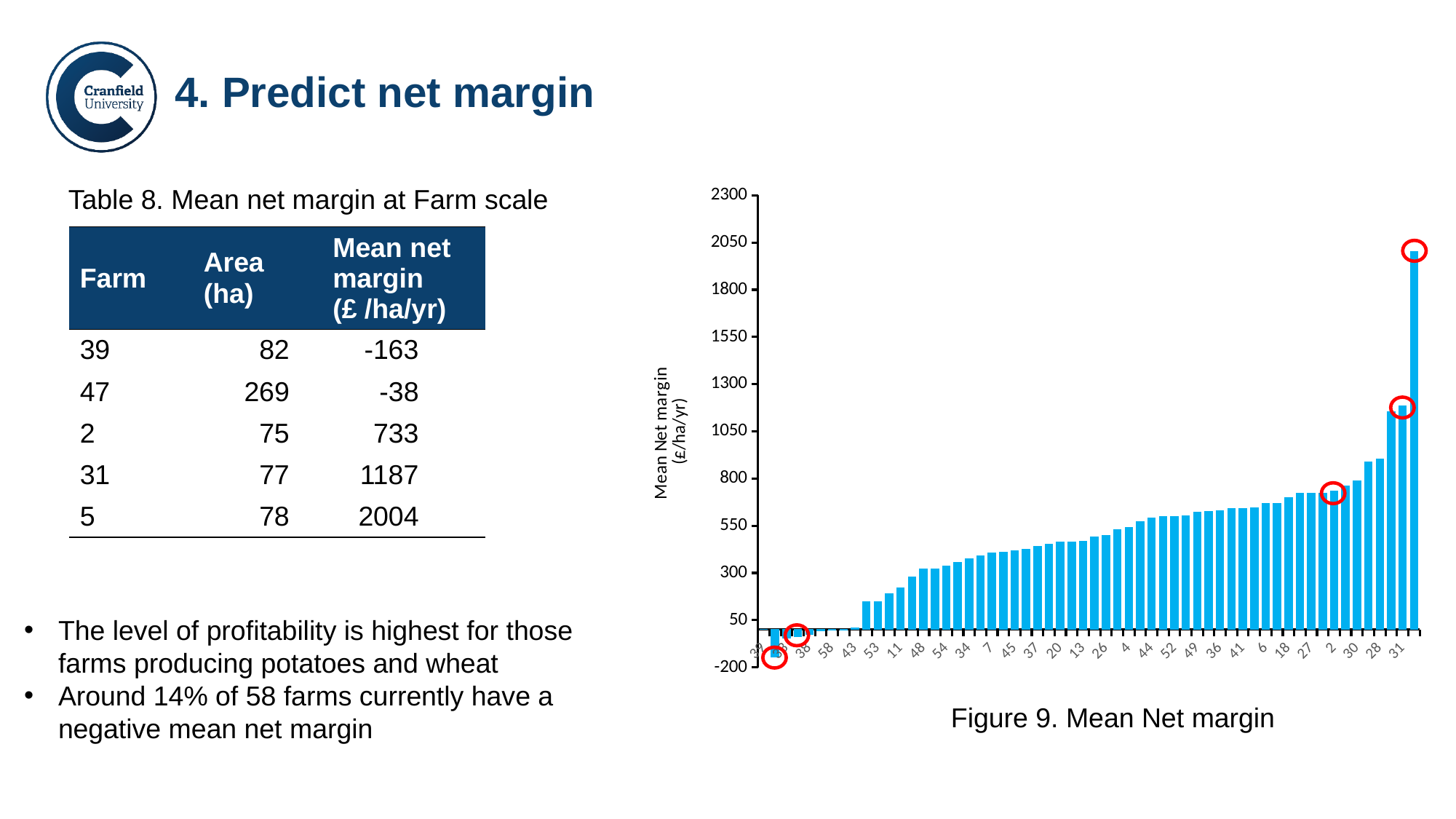
What kind of chart is Figure 9. Mean Net margin? bar chart In Figure 9, is the value for farm 39 greater or less than 50? less What is the y-axis label of the chart in Figure 9? Mean Net margin (£/ha/yr) In Figure 9, is the value for farm 31 greater or less than 1050? greater In Figure 9, is the value for farm 28 greater or less than 800? greater In Figure 9, which of farm 2 and farm 31 has the larger mean net margin? 31 In Figure 9, do the bar values rise or fall from left to right along the x axis? rise What is the caption of the chart on the slide? Figure 9. Mean Net margin